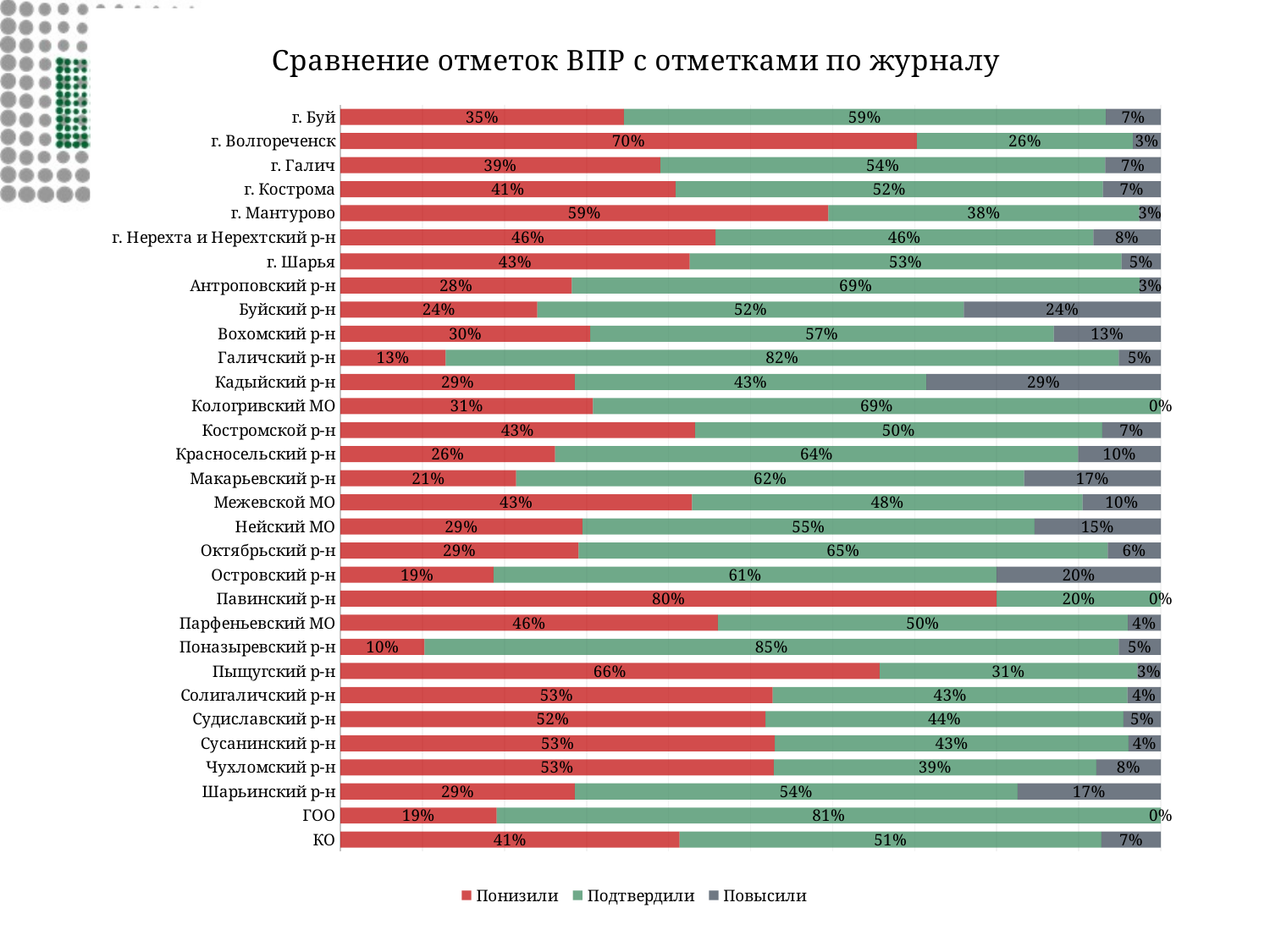
Which category has the highest value for Подтвердили? Поназыревский р-н Which category has the highest value for Повысили? Кадыйский р-н What is the value of Повысили for ГОО? 0% What is the value of Понизили for Павинский р-н? 80% What is the value of Повысили for Буйский р-н? 24% How many series does the legend list? 3 Which is larger: the Понизили value for Пыщугский р-н or for г. Мантурово? Пыщугский р-н What is the value of Подтвердили for Галичский р-н? 82% Which category has the lowest value for Понизили? Поназыревский р-н What is the title of the chart? Сравнение отметок ВПР с отметками по журналу What type of chart is shown on the slide? Stacked bar chart What is the difference between the Понизили values for г. Волгореченск and г. Буй? 35%